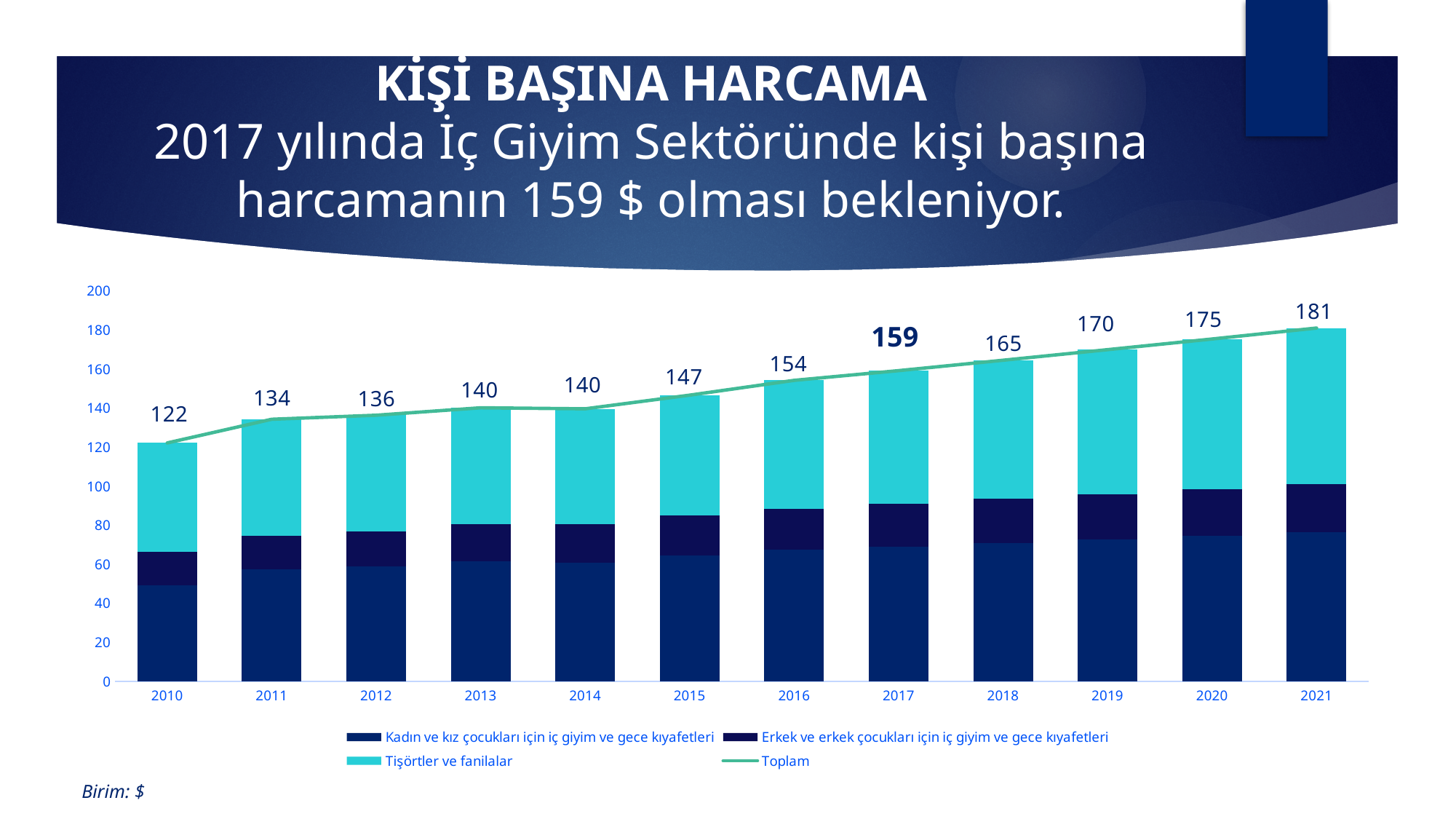
Which year has the highest total value? 2021 What is the total (Toplam) value for 2010? 122 Do the total values rise or fall from 2010 to 2021? rise What is the total (Toplam) value for 2021? 181 Which year has a larger total value, 2015 or 2019? 2019 What is the difference between the total values for 2021 and 2010? 59 What is the total (Toplam) value for 2017? 159 What is the difference between the total values for 2018 and 2017? 6 Which year has the lowest total value? 2010 Is the 'Kadın ve kız çocukları için iç giyim ve gece kıyafetleri' value for 2010 greater or less than 60? less How many series does the legend list? 4 How many years are shown on the x axis? 12